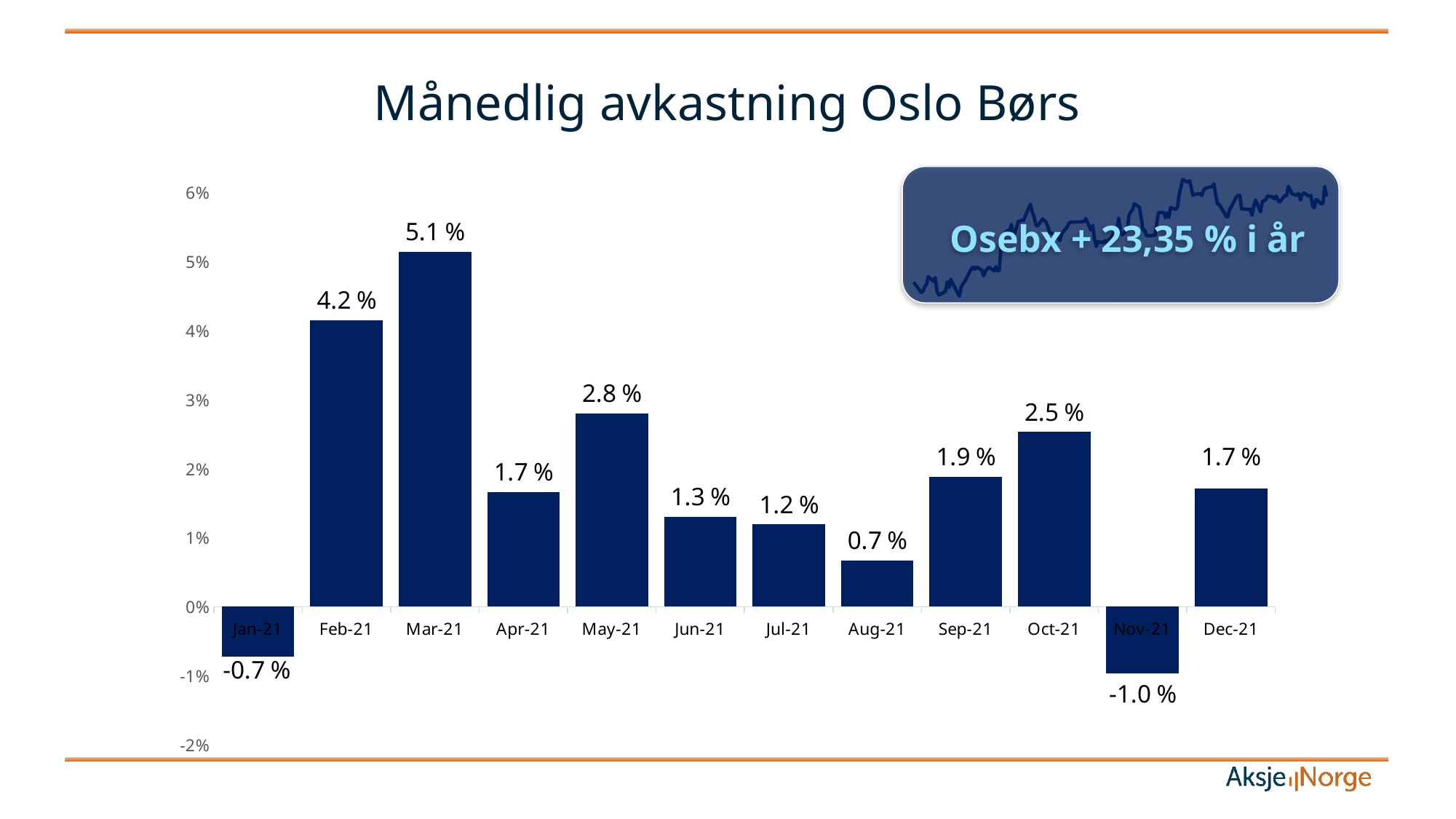
What is the monthly return shown for Nov-21? -1.0 % What kind of chart is shown on the slide? Bar chart What is the title of the chart? Månedlig avkastning Oslo Børs What is the monthly return shown for Oct-21? 2.5 % How many months are shown on the chart? 12 Is the value for Feb-21 greater or less than 4%? greater What year-to-date return for Osebx is stated in the box on the slide? + 23,35 % What is the monthly return shown for Mar-21? 5.1 % Which month has the lowest monthly return? Nov-21 Which month has the highest monthly return? Mar-21 What is the difference between the returns for Mar-21 and Feb-21? 0.9 % Which month has the larger return, May-21 or Sep-21? May-21